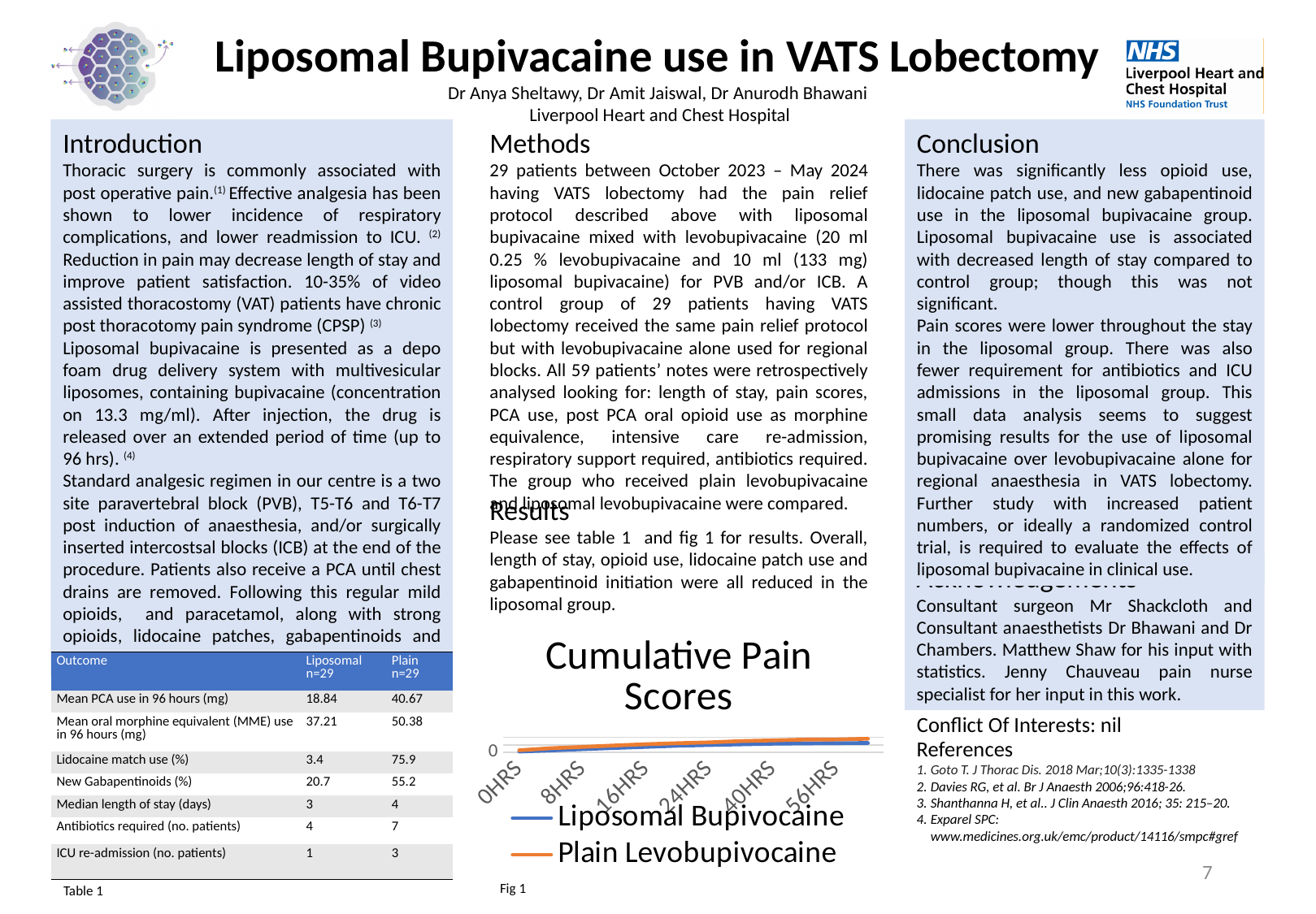
Which series in the "Cumulative Pain Scores" chart is drawn in orange? Plain Levobupivocaine What is the title of the chart on the slide? Cumulative Pain Scores What are the two series named in the legend of the "Cumulative Pain Scores" chart? Liposomal Bupivocaine and Plain Levobupivocaine How many series does the legend of the "Cumulative Pain Scores" chart list? 2 What kind of chart is the "Cumulative Pain Scores" chart? line chart Do the lines in the "Cumulative Pain Scores" chart rise or fall from 0HRS to 56HRS? rise